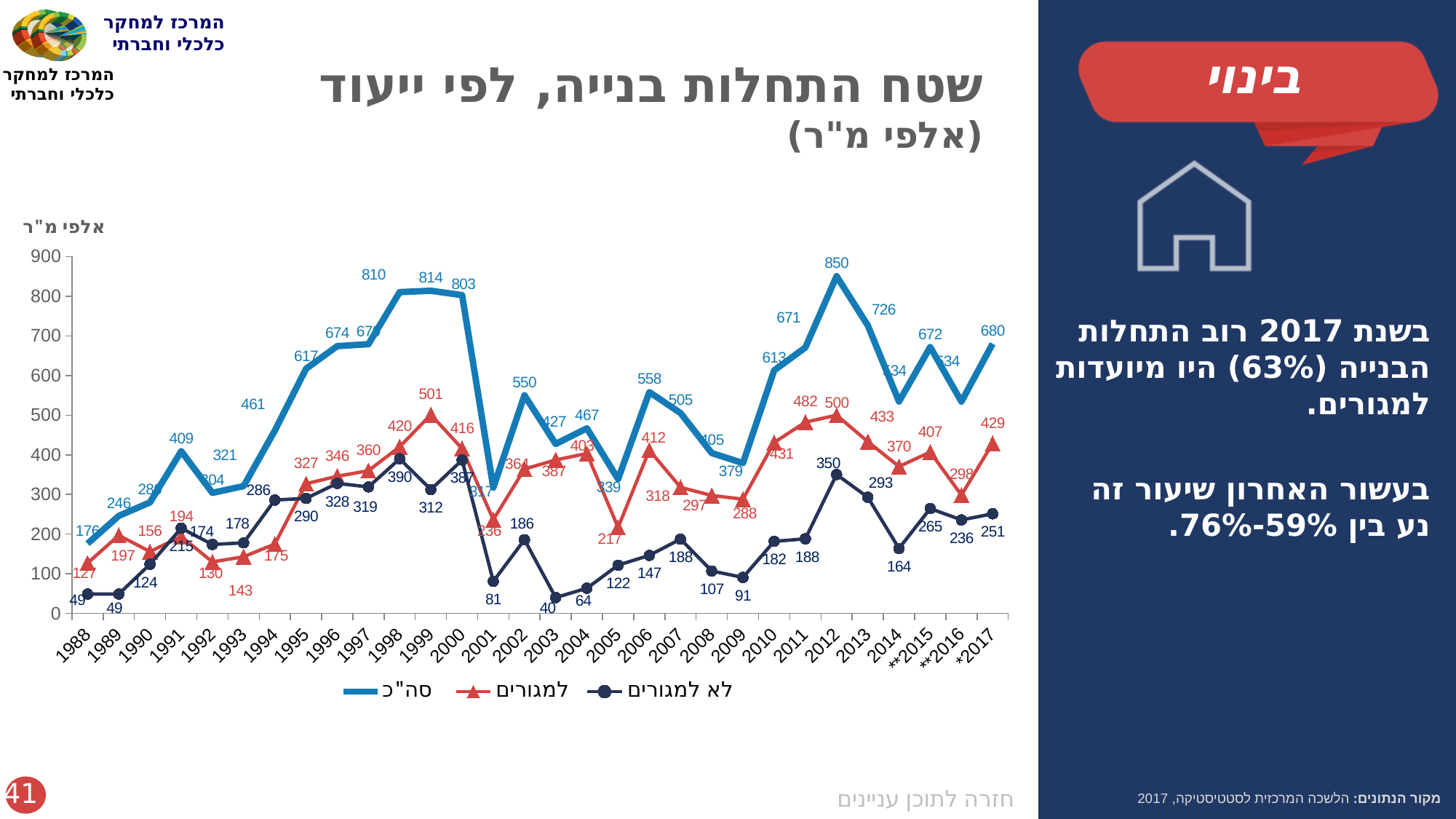
In which year does the סה"כ series reach its highest value? 2012 What is the value of the למגורים series in 2017? 429 Does the למגורים series rise or fall from 1994 to 1999? rise What is the value of the סה"כ series in 2012? 850 How many years are shown on the x axis? 30 How many series does the legend list? 3 Is the value of the סה"כ series in 2001 greater or less than 400? less What kind of chart is shown on the slide? line chart What is the difference between the למגורים value and the לא למגורים value in 2017? 178 In which year does the לא למגורים series reach its lowest value? 2003 What is the value of the לא למגורים series in 2003? 40 Which is larger in 1999: the למגורים value or the לא למגורים value? למגורים